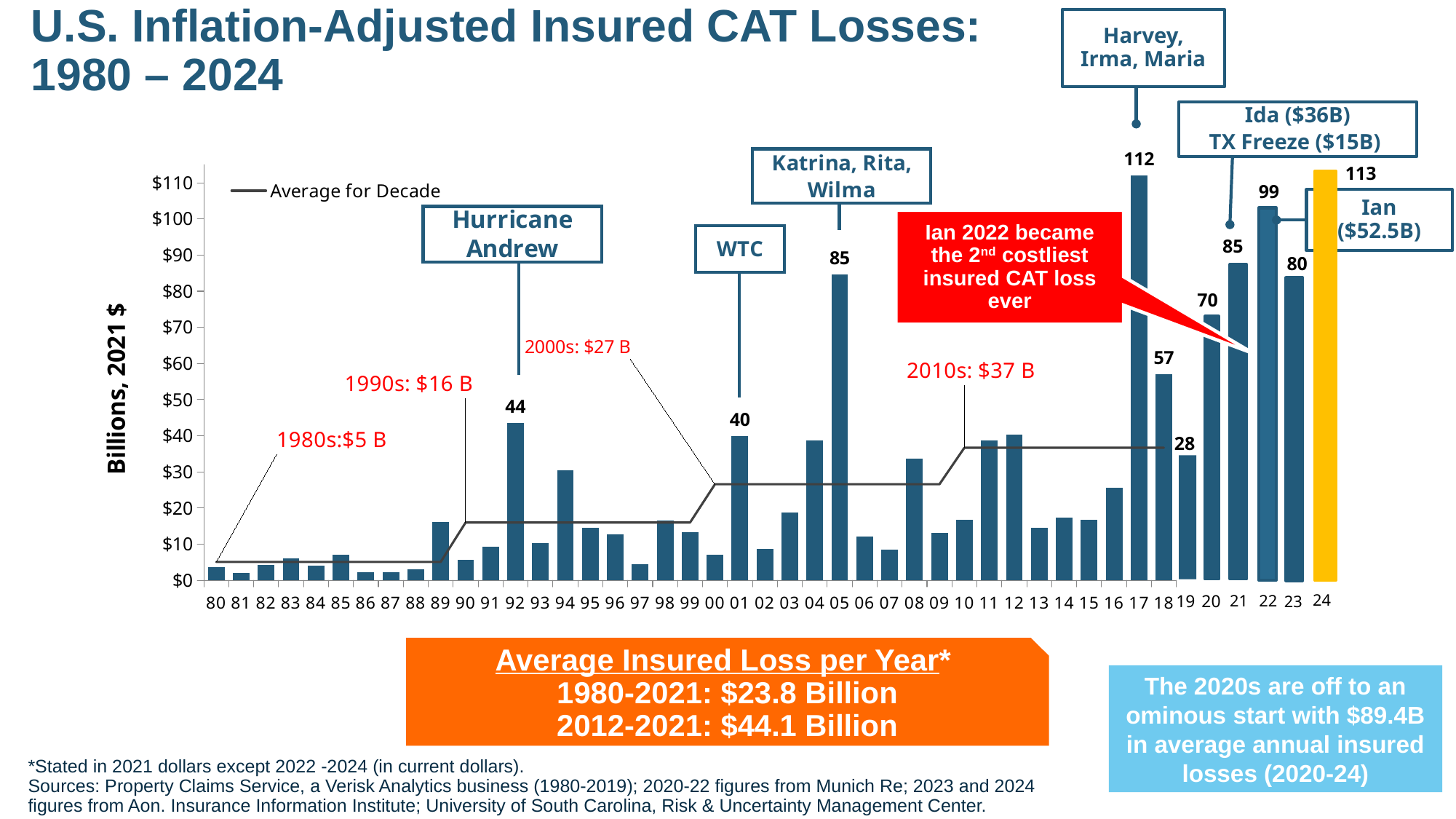
What is the difference between the labeled values for 2024 and 2023? 33 How many years (bars) are plotted on the chart? 45 Is the value for 1989 greater or less than $20? less What is the insured CAT loss value labeled for 2017? 112 Which year has the larger insured CAT loss, 2020 or 2023? 2023 What is the insured CAT loss value labeled for 2005? 85 What is the insured CAT loss value labeled for 1992? 44 What is the difference between the labeled values for 2017 and 2005? 27 Is the value for 1994 greater or less than $20? greater What is the average insured CAT loss for the 2010s shown on the chart? $37 B What type of chart is shown on the slide? Combination bar and line chart (bars with an 'Average for Decade' line) Which year has the highest insured CAT loss on the chart? 2024